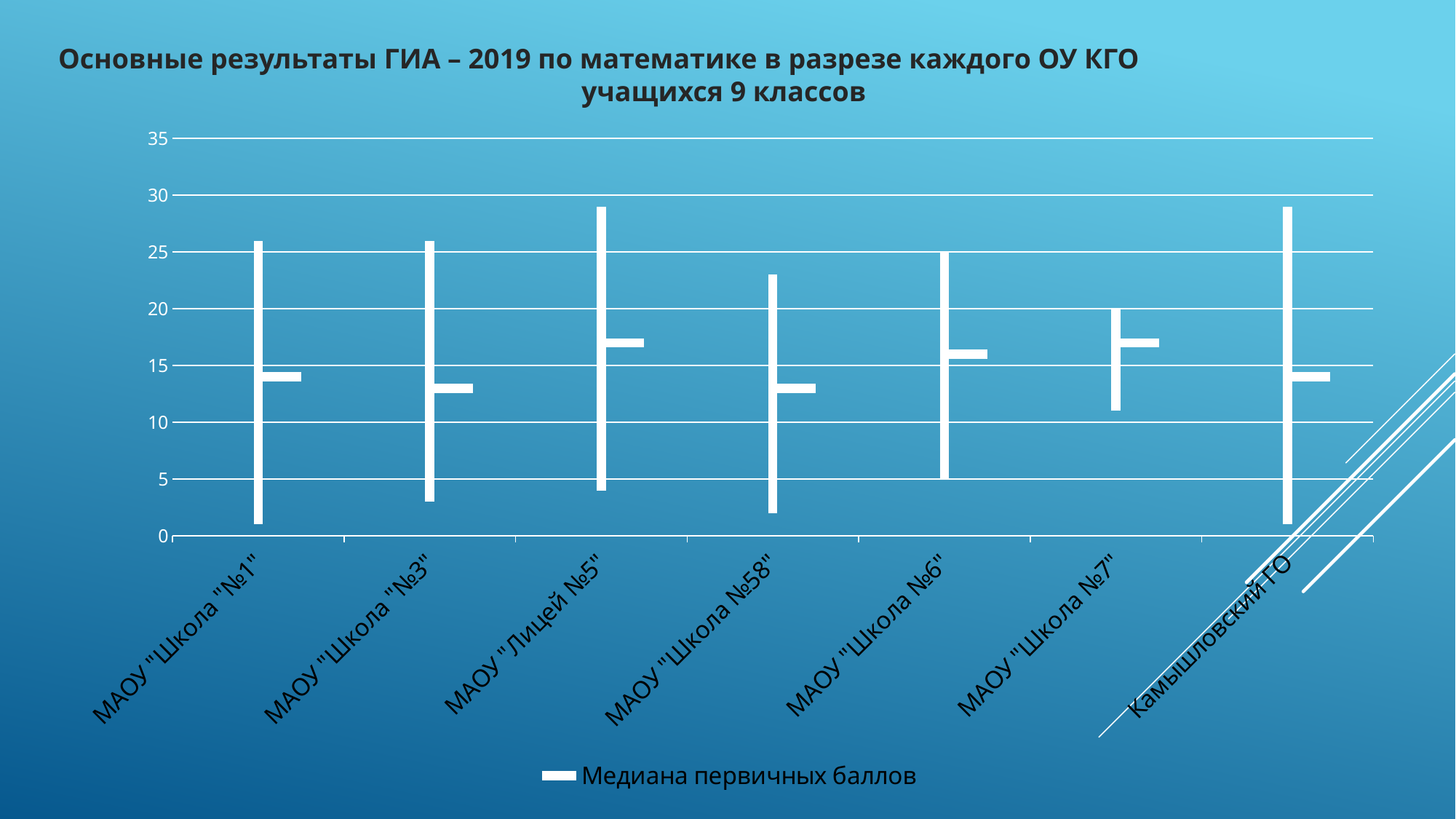
Which has the larger median value: МАОУ "Школа №7" or МАОУ "Школа №58"? МАОУ "Школа №7" How many schools/categories are shown on the x axis of the chart? 7 How many series does the chart legend list? 1 Is the median value for МАОУ "Школа №58" greater or less than 15? less Is the median value for МАОУ "Школа "№1" greater or less than 20? less Which has the larger median value: МАОУ "Лицей №5" or МАОУ "Школа "№3"? МАОУ "Лицей №5" Is the median value for МАОУ "Лицей №5" greater or less than 20? less What is the name of the series shown in the chart legend? Медиана первичных баллов What is the title of the chart? Основные результаты ГИА – 2019 по математике в разрезе каждого ОУ КГО учащихся 9 классов